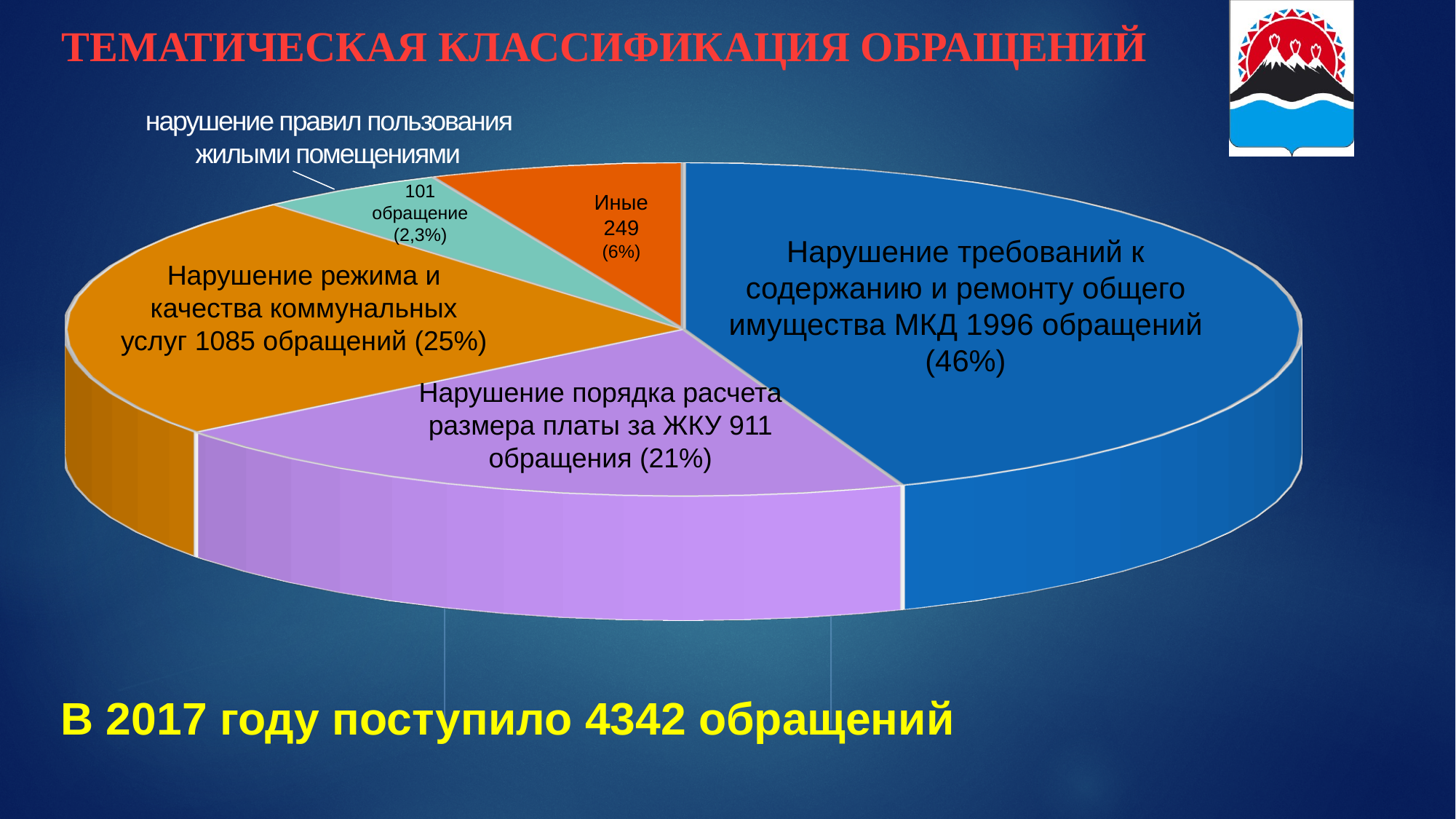
Which category has the smallest slice of the pie? нарушение правил пользования жилыми помещениями What is the difference in обращений between 'Нарушение режима и качества коммунальных услуг' and 'Нарушение порядка расчета размера платы за ЖКУ'? 174 How many обращения are in the slice 'Нарушение порядка расчета размера платы за ЖКУ'? 911 Which has more обращений: 'Иные' or 'нарушение правил пользования жилыми помещениями'? Иные What is the title of the chart on the slide? ТЕМАТИЧЕСКАЯ КЛАССИФИКАЦИЯ ОБРАЩЕНИЙ How many обращений are in the slice 'Нарушение требований к содержанию и ремонту общего имущества МКД'? 1996 Which category has the largest slice of the pie? Нарушение требований к содержанию и ремонту общего имущества МКД How many slices does the pie chart have? 5 What share of the pie does 'Нарушение режима и качества коммунальных услуг' take? 25% What kind of chart is shown on the slide? pie chart What share of the pie does the 'Иные' slice take? 6% What share of the pie does 'нарушение правил пользования жилыми помещениями' take? 2,3%